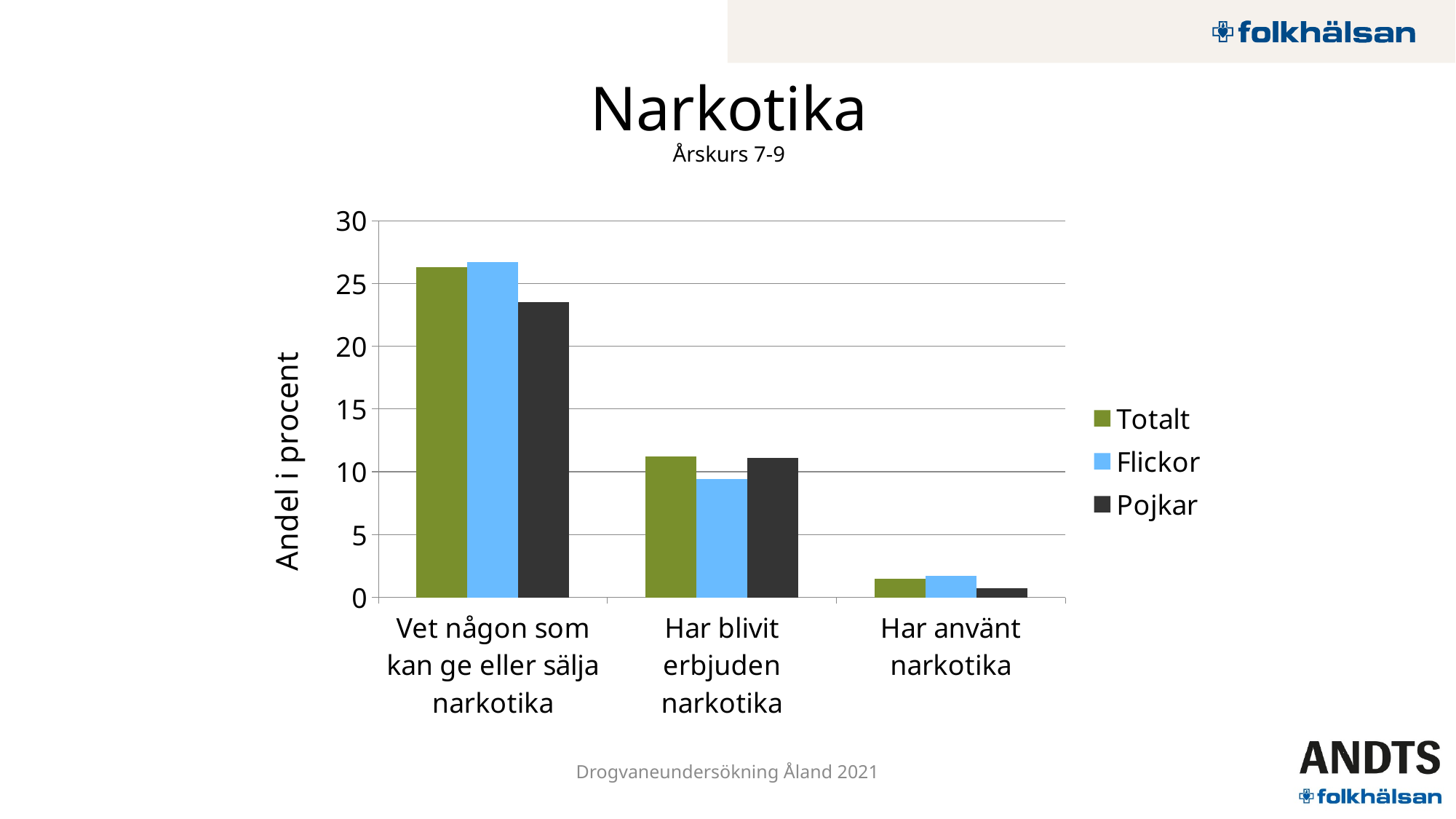
How many series does the legend list? 3 For 'Vet någon som kan ge eller sälja narkotika', which is larger: Flickor or Pojkar? Flickor Is the Flickor value for 'Har blivit erbjuden narkotika' greater or less than 10? less For 'Har blivit erbjuden narkotika', which is larger: Totalt or Flickor? Totalt Do the Totalt values rise or fall from left to right across the categories? fall For which category is the Flickor value lowest? Har använt narkotika What kind of chart is shown on the slide? bar chart For which category is the Pojkar value highest? Vet någon som kan ge eller sälja narkotika What is the title of the y axis? Andel i procent Is the Pojkar value for 'Vet någon som kan ge eller sälja narkotika' greater or less than 25? less Is the Flickor value for 'Vet någon som kan ge eller sälja narkotika' greater or less than 25? greater How many categories are shown on the x axis? 3